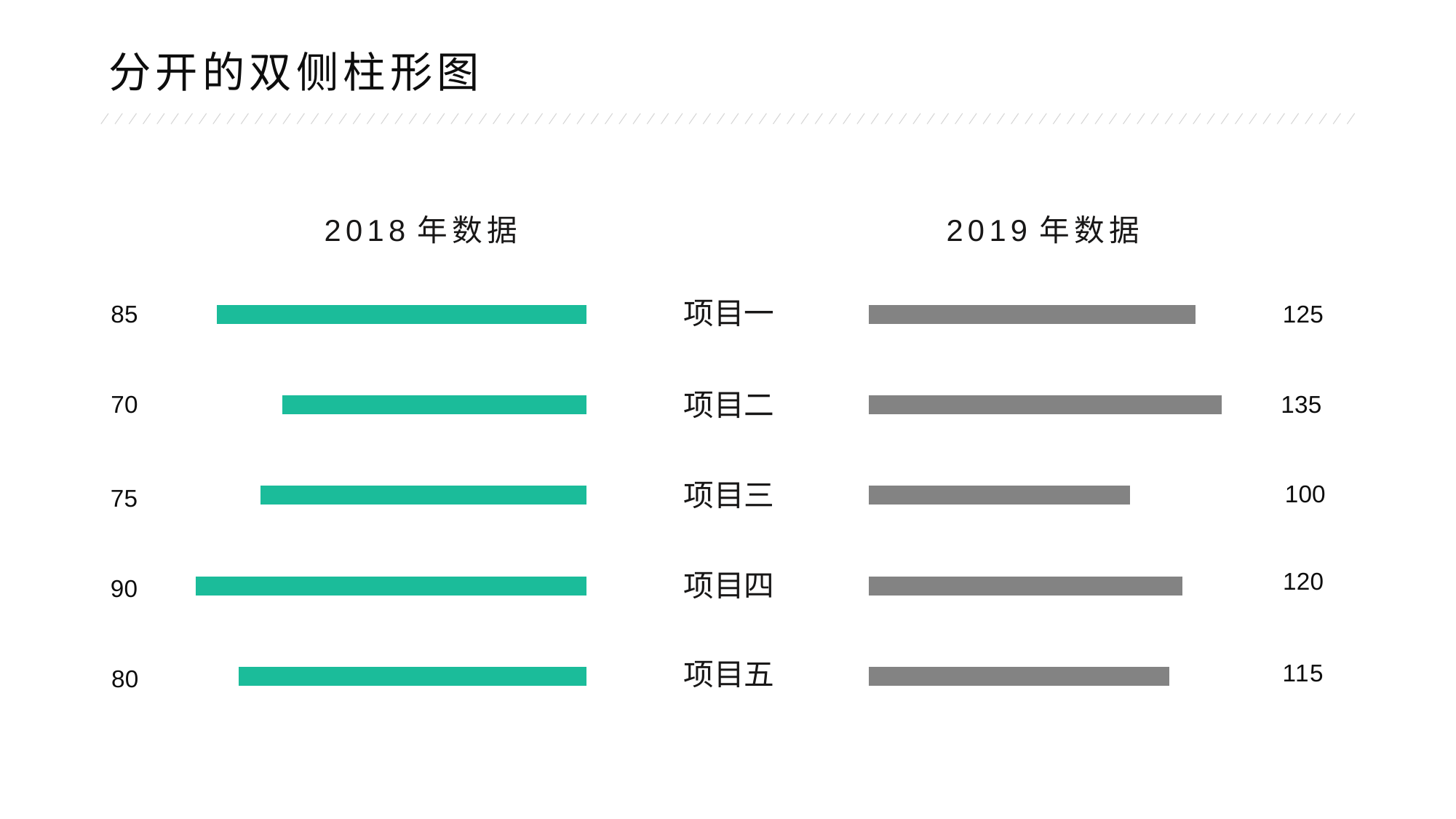
What kind of chart is the 2019 年数据 chart? bar chart In the 2019 年数据 chart, what is the value for 项目三? 100 In the 2018 年数据 chart, what is the difference between the values for 项目四 and 项目二? 20 In the 2018 年数据 chart, what is the value for 项目一? 85 In the 2019 年数据 chart, what is the difference between the values for 项目二 and 项目五? 20 In the 2018 年数据 chart, which category has the lowest value? 项目二 In the 2019 年数据 chart, which category has the lowest value? 项目三 How many categories are shown in the 2018 年数据 chart? 5 What colour are the bars in the 2018 年数据 chart? green Which is larger: the 2018 年数据 value for 项目五 or the 2019 年数据 value for 项目五? 2019 年数据 In the 2019 年数据 chart, which category has the highest value? 项目二 In the 2018 年数据 chart, which category has the highest value? 项目四